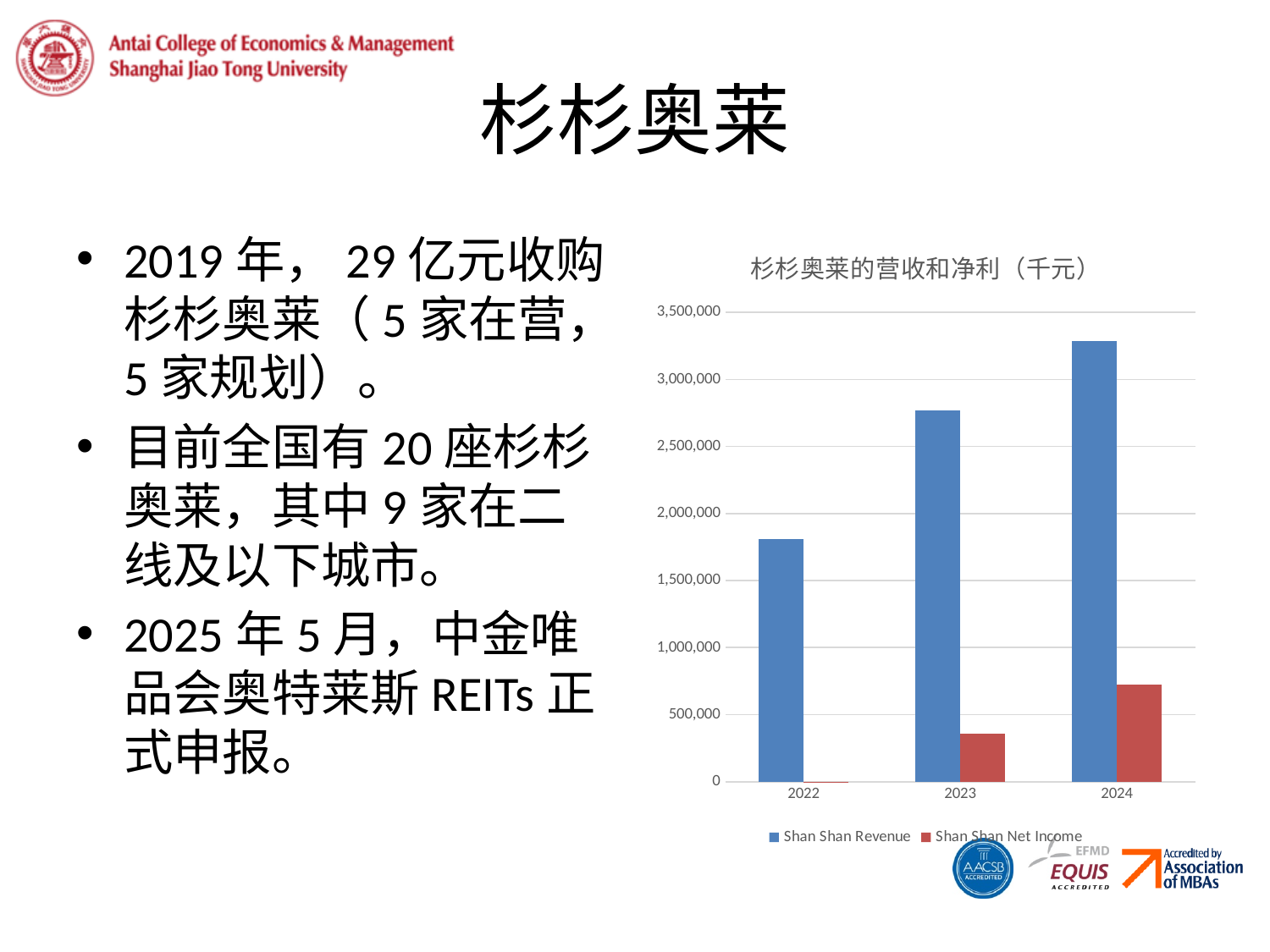
How many years are shown on the x axis of the chart? 3 What is the title of the chart? 杉杉奥莱的营收和净利（千元） What kind of chart is shown on the slide? bar chart Does Shan Shan Revenue rise or fall from 2022 to 2024? rise Which year has the lowest Shan Shan Net Income? 2022 Is the Shan Shan Net Income for 2023 greater or less than 500,000? less Which year has the lowest Shan Shan Revenue? 2022 Which colour represents Shan Shan Net Income in the chart? red Which year has the highest Shan Shan Revenue? 2024 Which is larger in 2024: Shan Shan Revenue or Shan Shan Net Income? Shan Shan Revenue Is the Shan Shan Revenue for 2024 greater or less than 3,000,000? greater How many series does the chart's legend list? 2